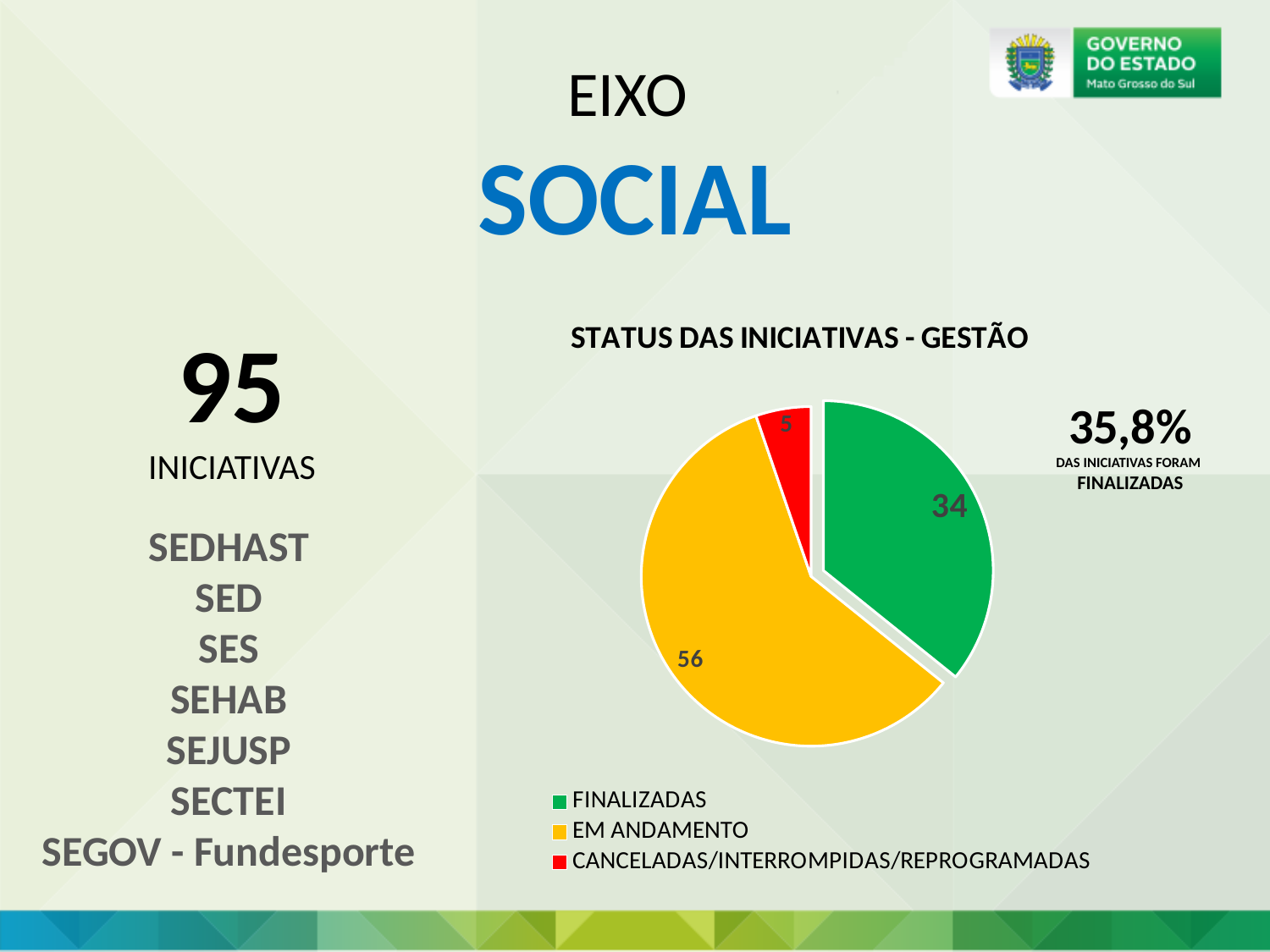
Which category has the largest slice? EM ANDAMENTO What colour is the FINALIZADAS slice? green Which category has the smallest slice? CANCELADAS/INTERROMPIDAS/REPROGRAMADAS Which is larger, FINALIZADAS or EM ANDAMENTO? EM ANDAMENTO What is the value for FINALIZADAS? 34 How many slices does the pie chart have? 3 What is the value for CANCELADAS/INTERROMPIDAS/REPROGRAMADAS? 5 What is the title of the chart? STATUS DAS INICIATIVAS - GESTÃO What type of chart is shown on the slide? pie chart What is the value for EM ANDAMENTO? 56 What is the difference between the EM ANDAMENTO and FINALIZADAS values? 22 How many entries does the legend list? 3